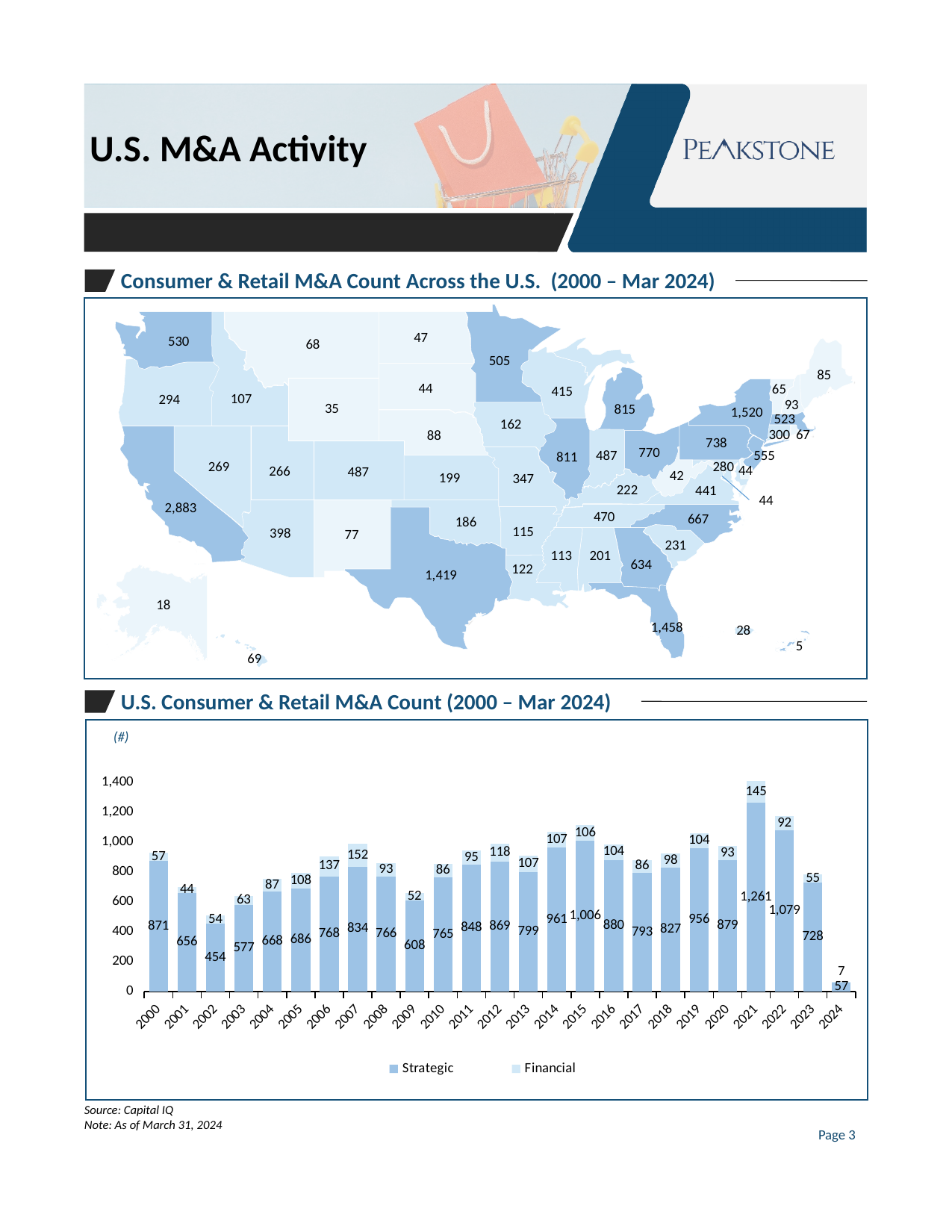
In the U.S. Consumer & Retail M&A Count chart, what is the Financial value for 2007? 152 How many series does the legend of the U.S. Consumer & Retail M&A Count chart list? 2 In the U.S. Consumer & Retail M&A Count chart, what is the total of the stacked bar for 2021? 1,406 In the U.S. Consumer & Retail M&A Count chart, what is the total of the stacked bar for 2002? 508 In the U.S. Consumer & Retail M&A Count chart, what is the difference between the Strategic values for 2015 and 2014? 45 What kind of chart is the U.S. Consumer & Retail M&A Count (2000 – Mar 2024) chart? Stacked bar chart In the U.S. Consumer & Retail M&A Count chart, which year has the lowest Financial value? 2024 How many years are shown on the x axis of the U.S. Consumer & Retail M&A Count chart? 25 In the Consumer & Retail M&A Count Across the U.S. map, what is the highest count shown for any state? 2,883 In the U.S. Consumer & Retail M&A Count chart, which is larger, the Strategic value for 2012 or for 2013? 2012 In the U.S. Consumer & Retail M&A Count chart, which year has the highest Strategic value? 2021 In the U.S. Consumer & Retail M&A Count chart, what is the Strategic value for 2021? 1,261